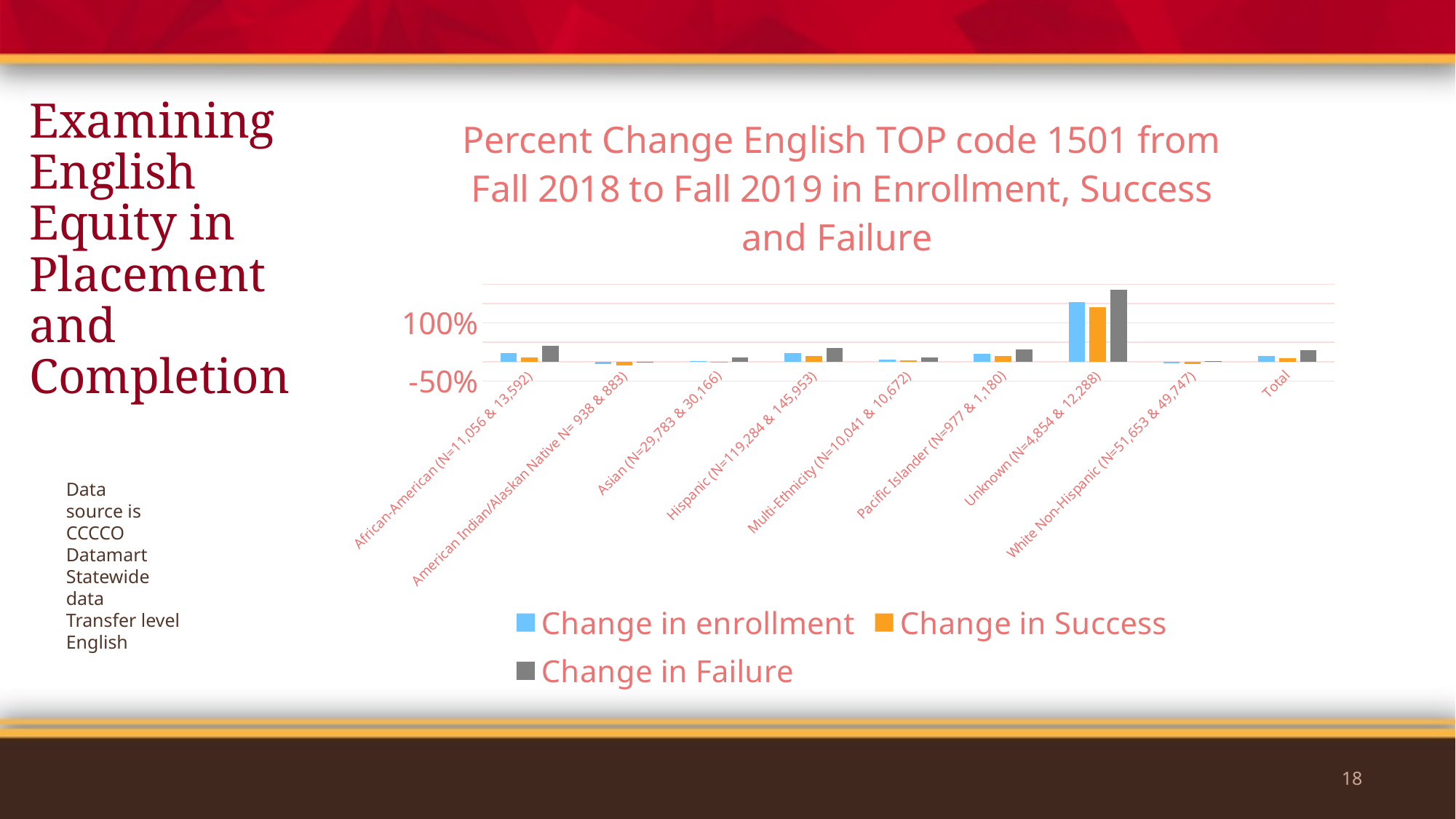
Which colour represents Change in Failure in the chart? Gray Is the Change in Failure for African-American (N=11,056 & 13,592) greater or less than 100%? less Which category has the highest Change in Failure? Unknown (N=4,854 & 12,288) How many categories are shown along the x axis of the chart? 9 Is the Change in Failure for Unknown (N=4,854 & 12,288) greater or less than 100%? greater How many series does the legend list? 3 What is the title of the chart? Percent Change English TOP code 1501 from Fall 2018 to Fall 2019 in Enrollment, Success and Failure Which category has the highest Change in enrollment? Unknown (N=4,854 & 12,288) Is the Change in enrollment for Unknown (N=4,854 & 12,288) greater or less than 100%? greater Which has the larger Change in enrollment: Unknown (N=4,854 & 12,288) or Hispanic (N=119,284 & 145,953)? Unknown (N=4,854 & 12,288) Which category has the highest Change in Success? Unknown (N=4,854 & 12,288) What kind of chart is shown on the slide? Bar chart